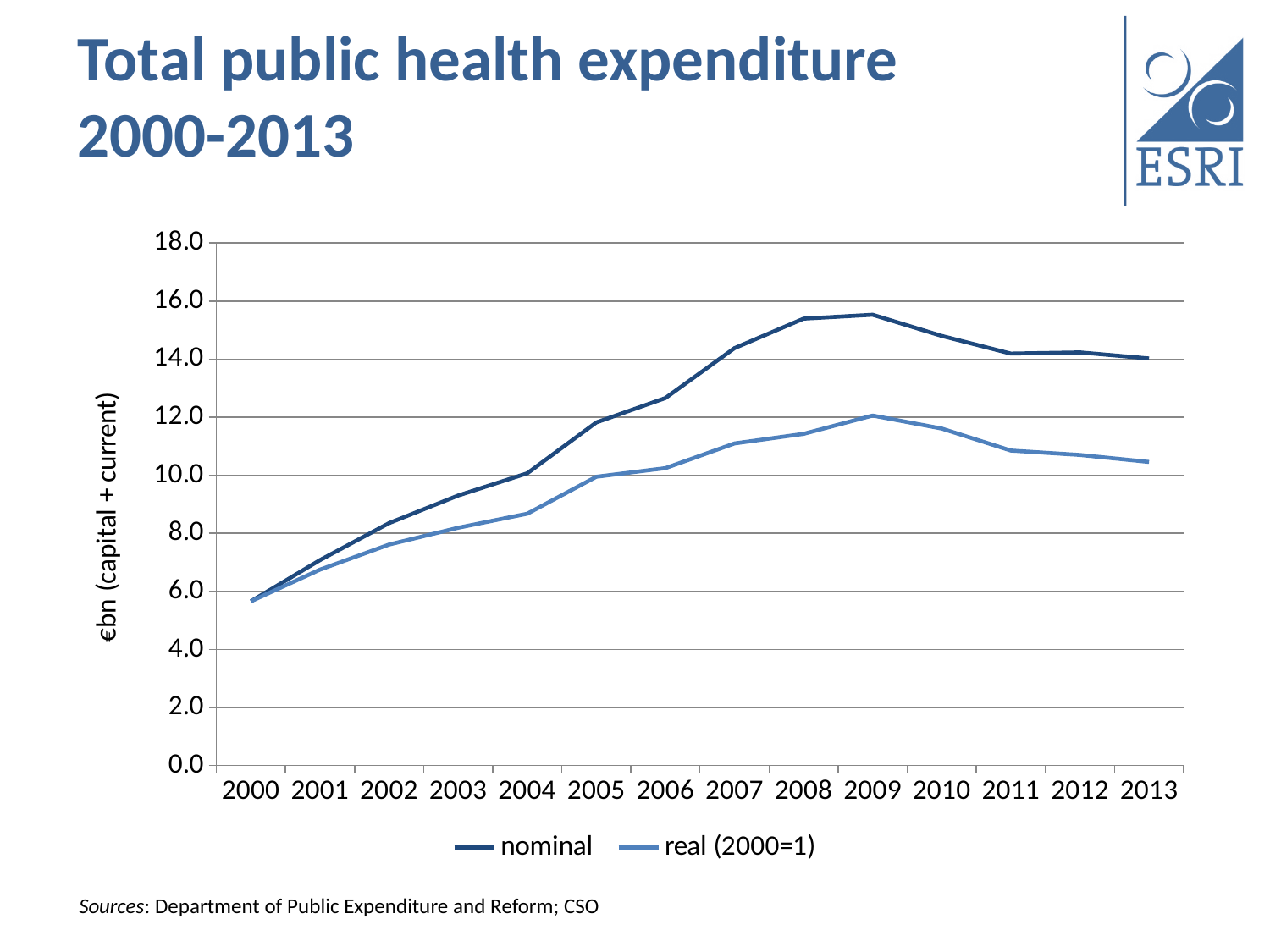
How many years are plotted along the x axis? 14 How many series does the legend list? 2 What kind of chart is shown on the slide? line chart What is the label on the vertical axis? €bn (capital + current) Is the real (2000=1) value for 2002 greater or less than 8.0? less Does the nominal series rise or fall between 2009 and 2013? fall Is the nominal value for 2009 greater or less than 14.0? greater Is the real (2000=1) value for 2013 greater or less than 10.0? greater In which year is the real (2000=1) series at its lowest? 2000 Which series has the larger value in 2009, nominal or real (2000=1)? nominal In which year does the nominal series reach its highest value? 2009